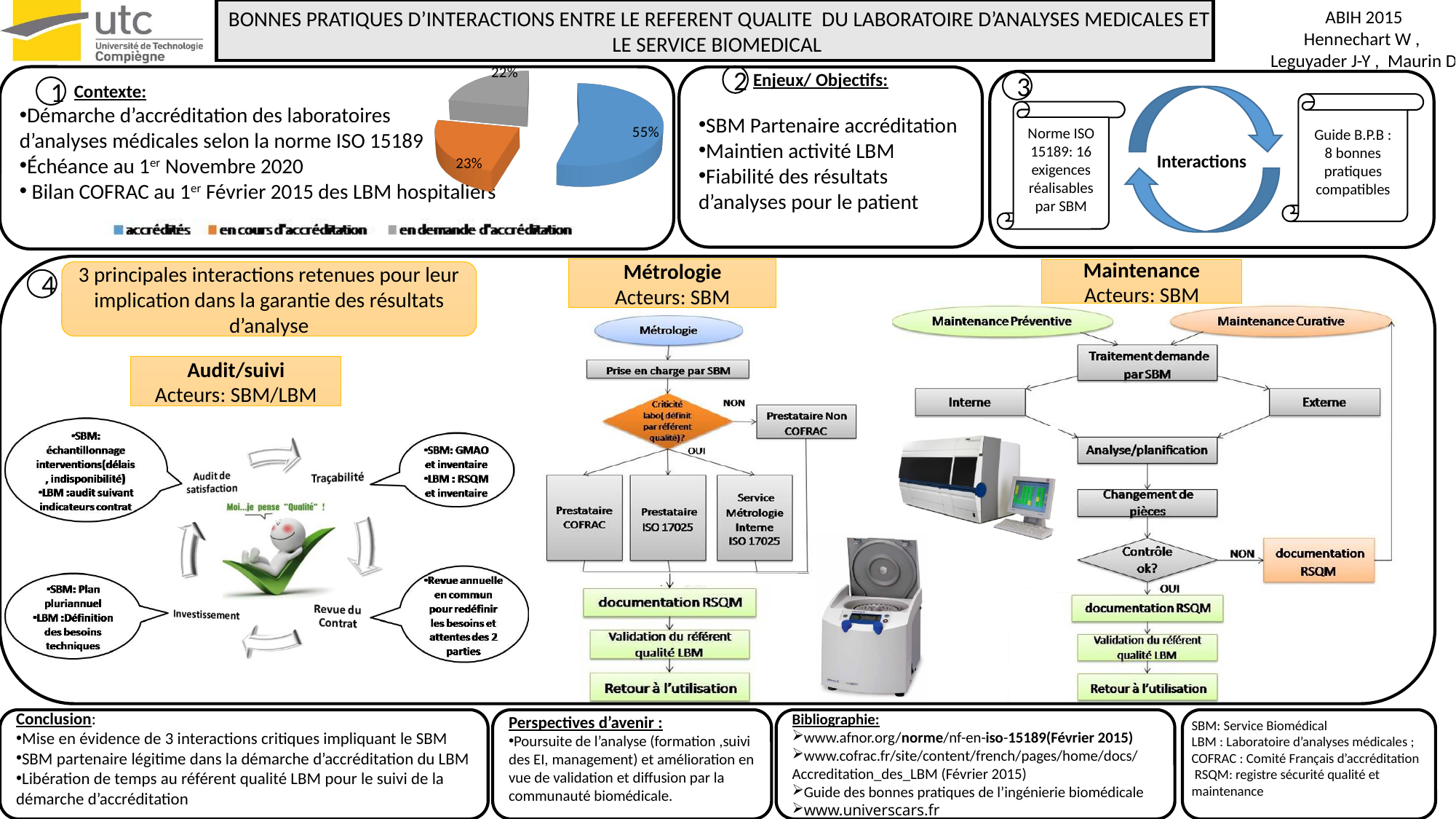
Which slice is larger in the pie chart: 'en cours d'accréditation' or 'en demande d'accréditation'? en cours d'accréditation In the pie chart, what share is labelled for 'en demande d'accréditation'? 22% Which category has the largest slice in the pie chart? accrédités Which category has the smallest slice in the pie chart? en demande d'accréditation In the pie chart, what share is labelled for 'en cours d'accréditation'? 23% In the pie chart, what share is labelled for 'accrédités'? 55% What colour is the 'en cours d'accréditation' slice in the pie chart? orange How many entries does the pie chart legend list? 3 What is the difference in percentage points between the 'accrédités' slice and the 'en cours d'accréditation' slice? 32 How many slices does the pie chart have? 3 What colour is the 'accrédités' slice in the pie chart? blue What kind of chart is shown in the Contexte section? pie chart